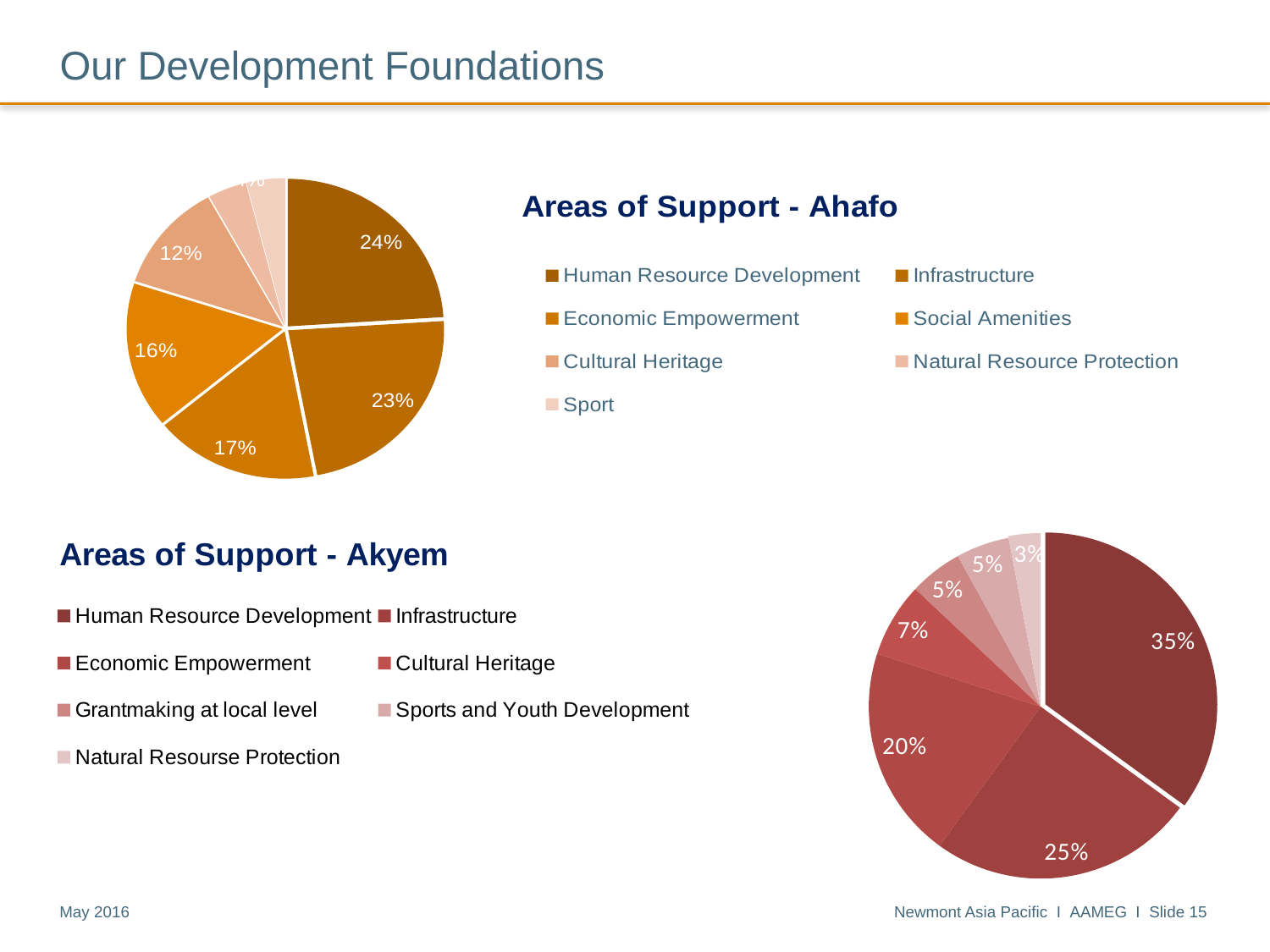
What kind of chart is the Areas of Support - Ahafo chart? Pie chart In the Areas of Support - Akyem chart, which is larger: the Infrastructure share or the Cultural Heritage share? Infrastructure In the Areas of Support - Akyem chart, which category has the smallest share? Natural Resourse Protection In the Areas of Support - Akyem chart, what share does Human Resource Development have? 35% How many categories does the legend of the Areas of Support - Ahafo chart list? 7 In the Areas of Support - Ahafo chart, what is the difference between the Infrastructure share and the Social Amenities share? 7% In the Areas of Support - Akyem chart, what is the difference between the Human Resource Development share and the Infrastructure share? 10% In the Areas of Support - Ahafo chart, which category has the largest share? Human Resource Development How many categories does the legend of the Areas of Support - Akyem chart list? 7 In the Areas of Support - Ahafo chart, what share does Cultural Heritage have? 12% In the Areas of Support - Akyem chart, what share does Economic Empowerment have? 20% In the Areas of Support - Ahafo chart, what share does Human Resource Development have? 24%